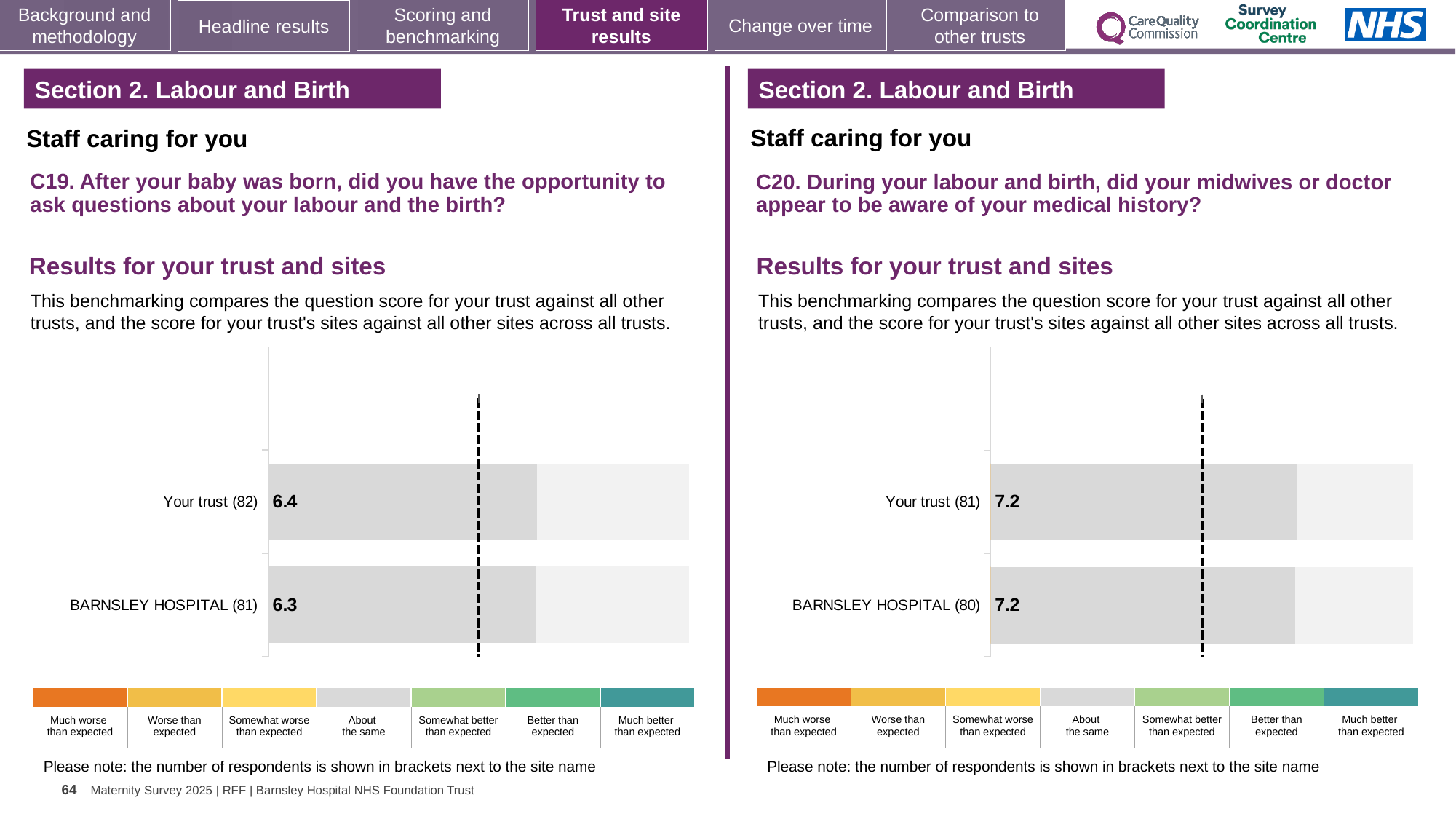
In the C20 chart on the right, is the score for Your trust higher than, lower than, or equal to the score for BARNSLEY HOSPITAL? Equal In the C20 chart on the right, what is the score for Your trust? 7.2 In the C20 chart on the right, how many respondents are shown in brackets for BARNSLEY HOSPITAL? 80 In the C19 chart on the left, what is the score for BARNSLEY HOSPITAL? 6.3 How many bars are plotted in the C20 chart on the right? 2 How many bars are plotted in the C19 chart on the left? 2 In the C19 chart on the left, how many respondents are shown in brackets for Your trust? 82 In the C19 chart on the left, which has the higher score, Your trust or BARNSLEY HOSPITAL? Your trust In the C20 chart on the right, what is the score for BARNSLEY HOSPITAL? 7.2 What type of chart is used for the C20 results on the right? Bar chart In the C19 chart on the left, what is the difference between the Your trust score and the BARNSLEY HOSPITAL score? 0.1 In the C19 chart on the left, what is the score for Your trust? 6.4